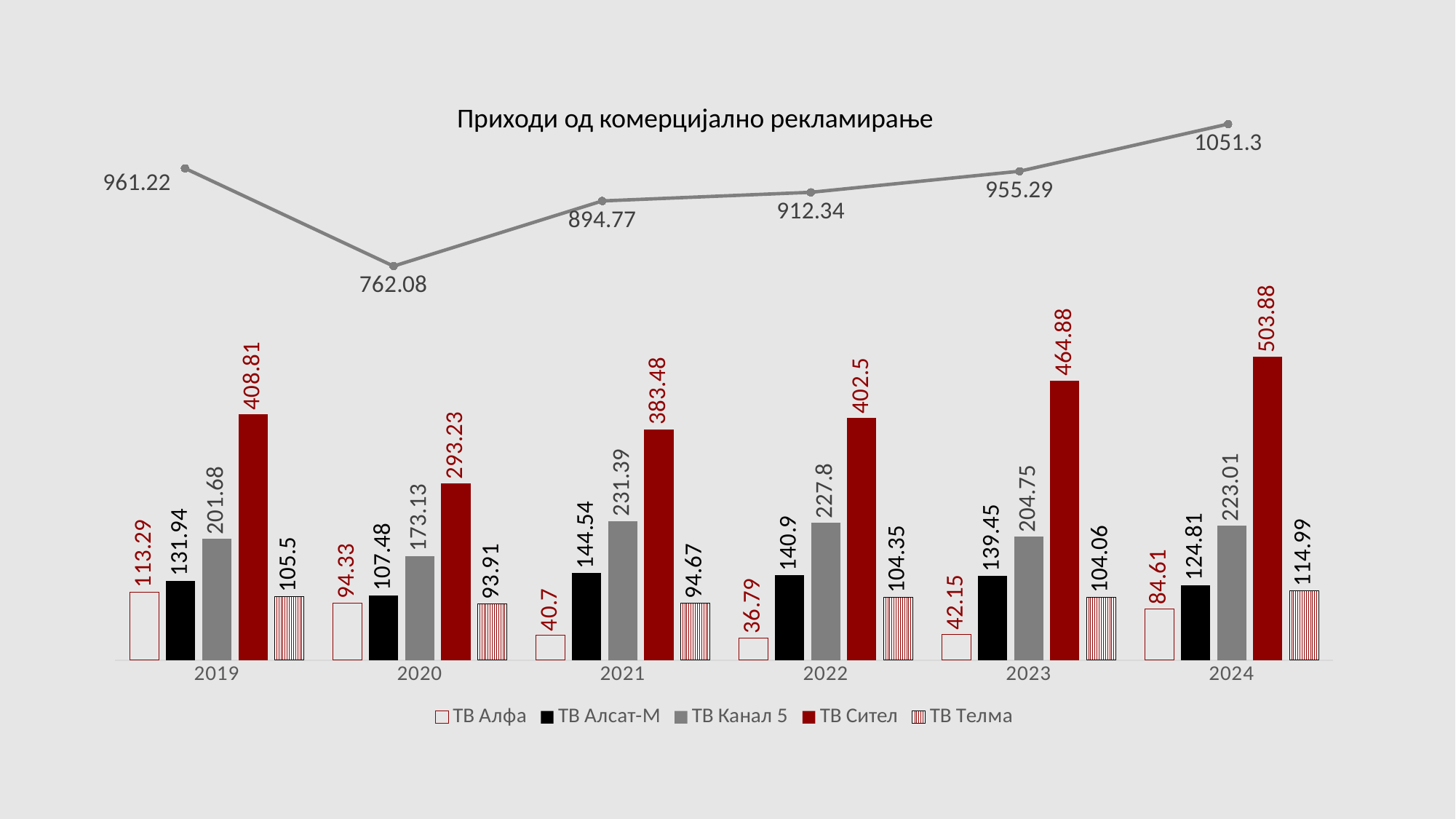
How many series does the legend list? 5 What is the value of the line series in 2020? 762.08 What is the value for ТВ Алфа in 2019? 113.29 Does the line series rise or fall from 2020 to 2024? rise In which year is the value for ТВ Сител the highest? 2024 In which year is the value for ТВ Алфа the lowest? 2022 What is the difference between the ТВ Сител values for 2024 and 2023? 39 How many years are shown on the x axis? 6 What is the value for ТВ Телма in 2023? 104.06 Which is larger: the value for ТВ Канал 5 in 2021 or in 2022? 2021 What is the difference between the line series values for 2024 and 2019? 90.08 What is the value for ТВ Сител in 2024? 503.88